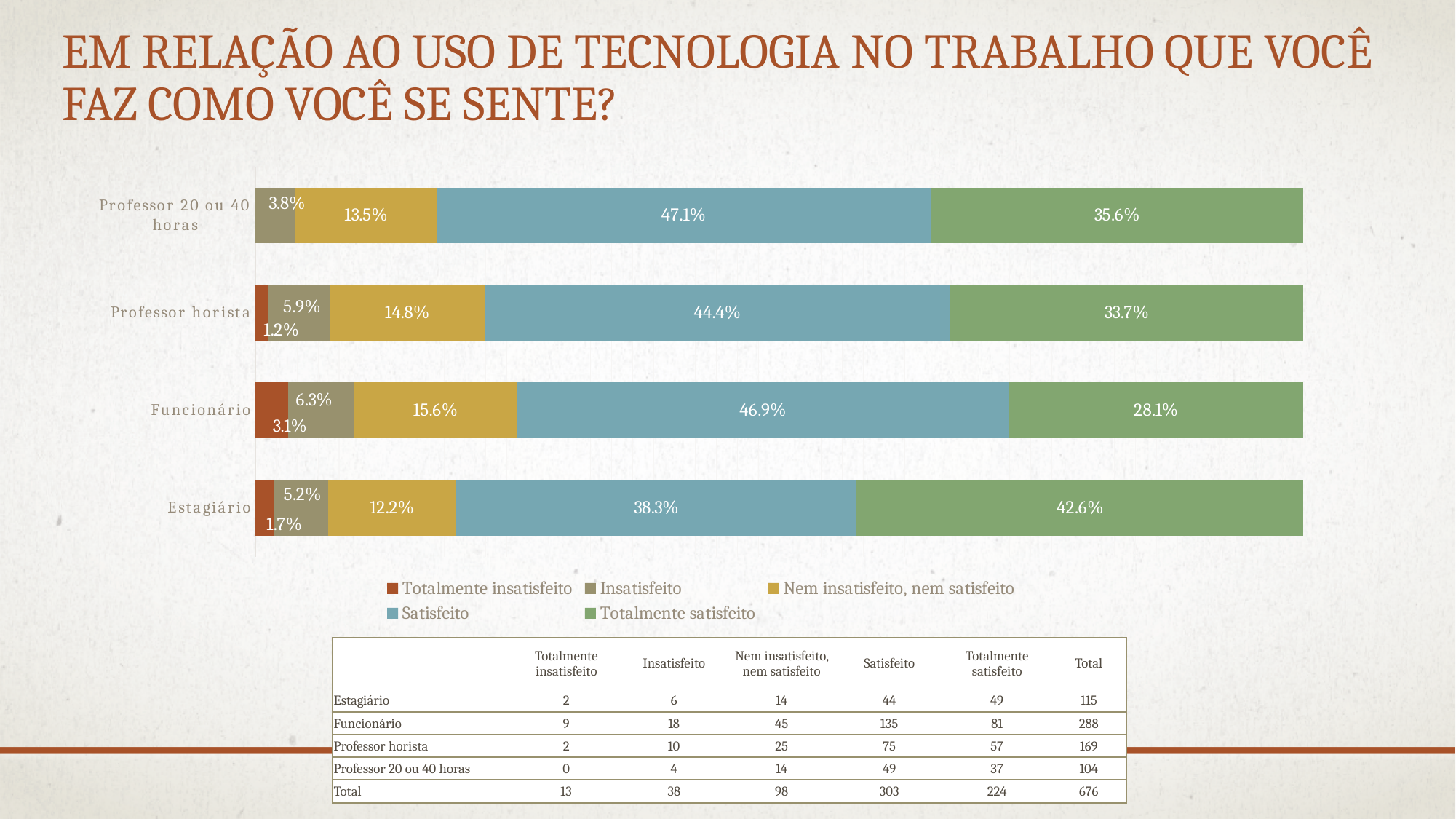
What percentage of 'Professor 20 ou 40 horas' respondents answered 'Satisfeito'? 47.1% How many series does the legend list? 5 For 'Funcionário', what is the difference between the 'Satisfeito' and 'Totalmente satisfeito' percentages? 18.8 percentage points How many categories (bars) are shown in the chart? 4 Which category has the highest 'Totalmente satisfeito' percentage? Estagiário What kind of chart is shown on the slide? Stacked bar chart What is the 'Totalmente insatisfeito' value for 'Funcionário'? 3.1% Which colour represents 'Satisfeito' in the chart? Blue What is the 'Totalmente satisfeito' value for 'Estagiário'? 42.6% Which category has the lowest 'Satisfeito' percentage? Estagiário Which category has the highest 'Nem insatisfeito, nem satisfeito' percentage? Funcionário Which has a larger 'Nem insatisfeito, nem satisfeito' share: 'Funcionário' or 'Professor horista'? Funcionário